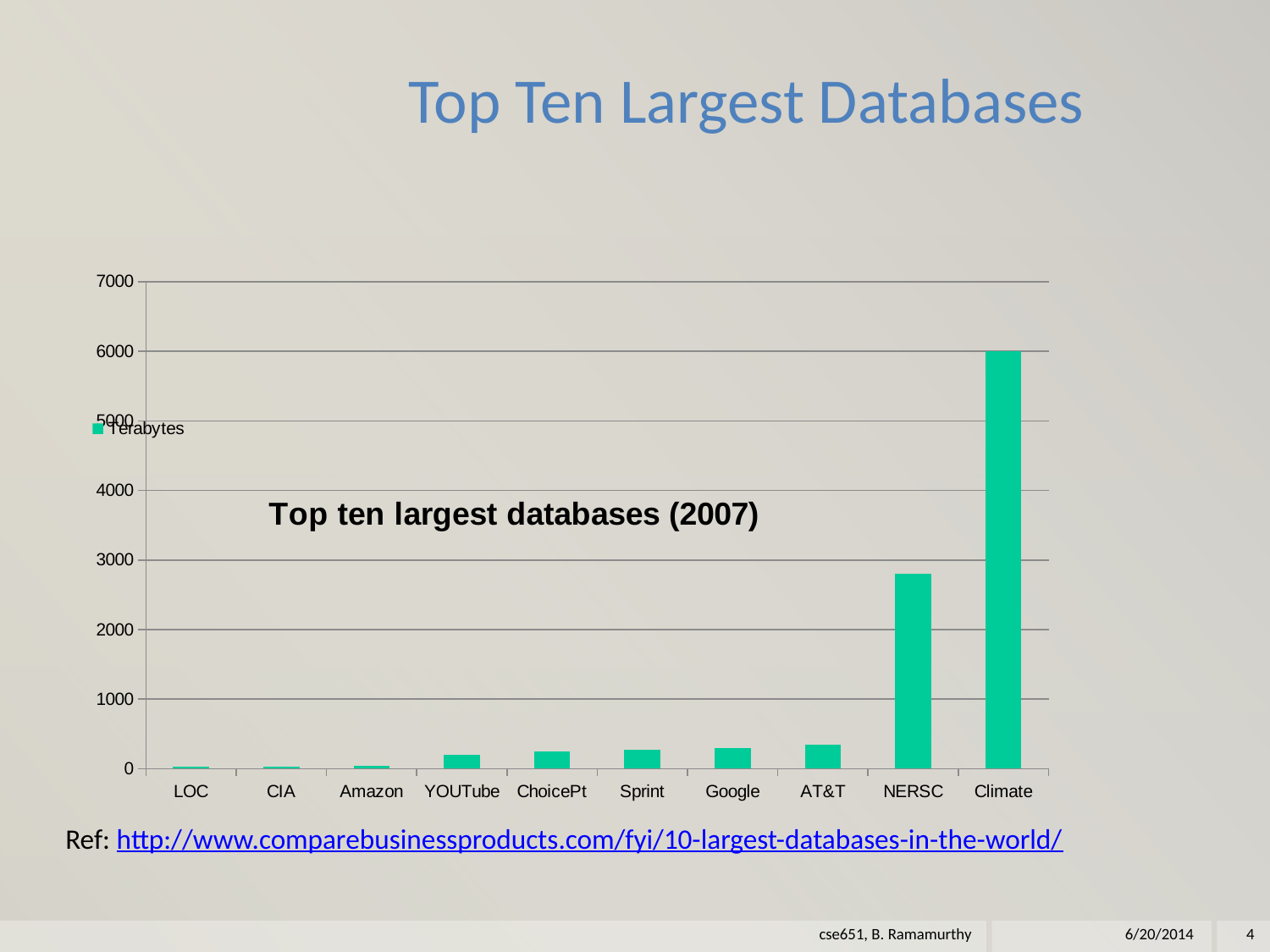
How many databases (categories) are plotted on the chart? 10 Which database has the highest value on the chart? Climate How many series does the legend list? 1 Is the value for Google greater or less than 1000? less Which has the larger value, Climate or NERSC? Climate Is the value for NERSC greater or less than 2000? greater Is the value for NERSC greater or less than 3000? less What is the name of the series shown in the legend? Terabytes Which has the larger value, NERSC or Google? NERSC Do the values generally rise or fall moving from left to right along the x axis? rise What kind of chart is shown on the slide? bar chart